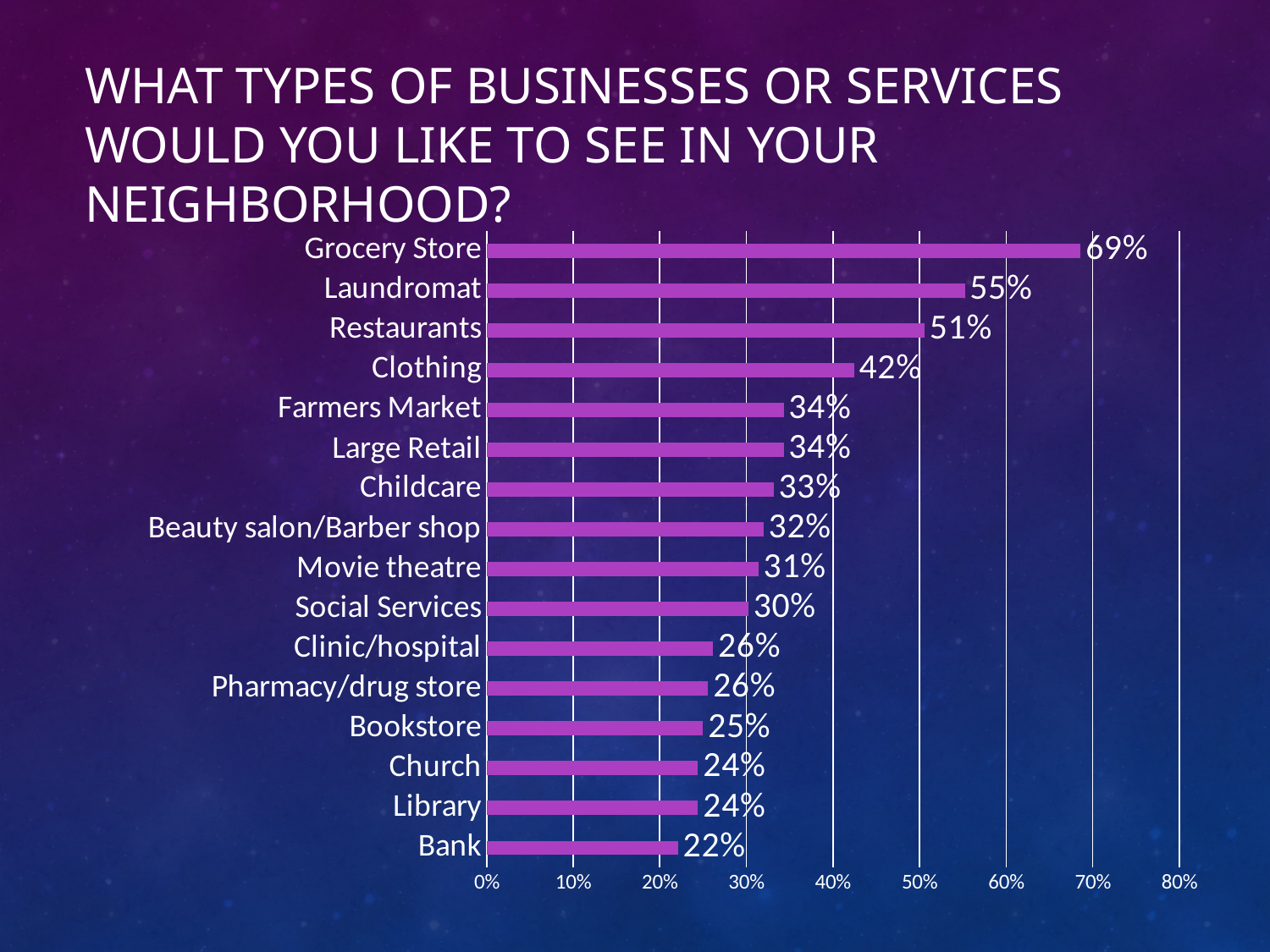
Is the value for Clothing greater or less than 40%? greater What is the difference between the values for Grocery Store and Laundromat? 14% Which is larger, the value for Childcare or the value for Social Services? Childcare Which category has the highest value? Grocery Store What is the value for Laundromat? 55% How many categories are shown in the chart? 16 What kind of chart is shown on the slide? Bar chart What is the value for Bookstore? 25% What percentage of respondents would like to see a Grocery Store in their neighborhood? 69% Which category has the lowest value? Bank What is the value for Pharmacy/drug store? 26% What is the difference between the values for Restaurants and Clothing? 9%